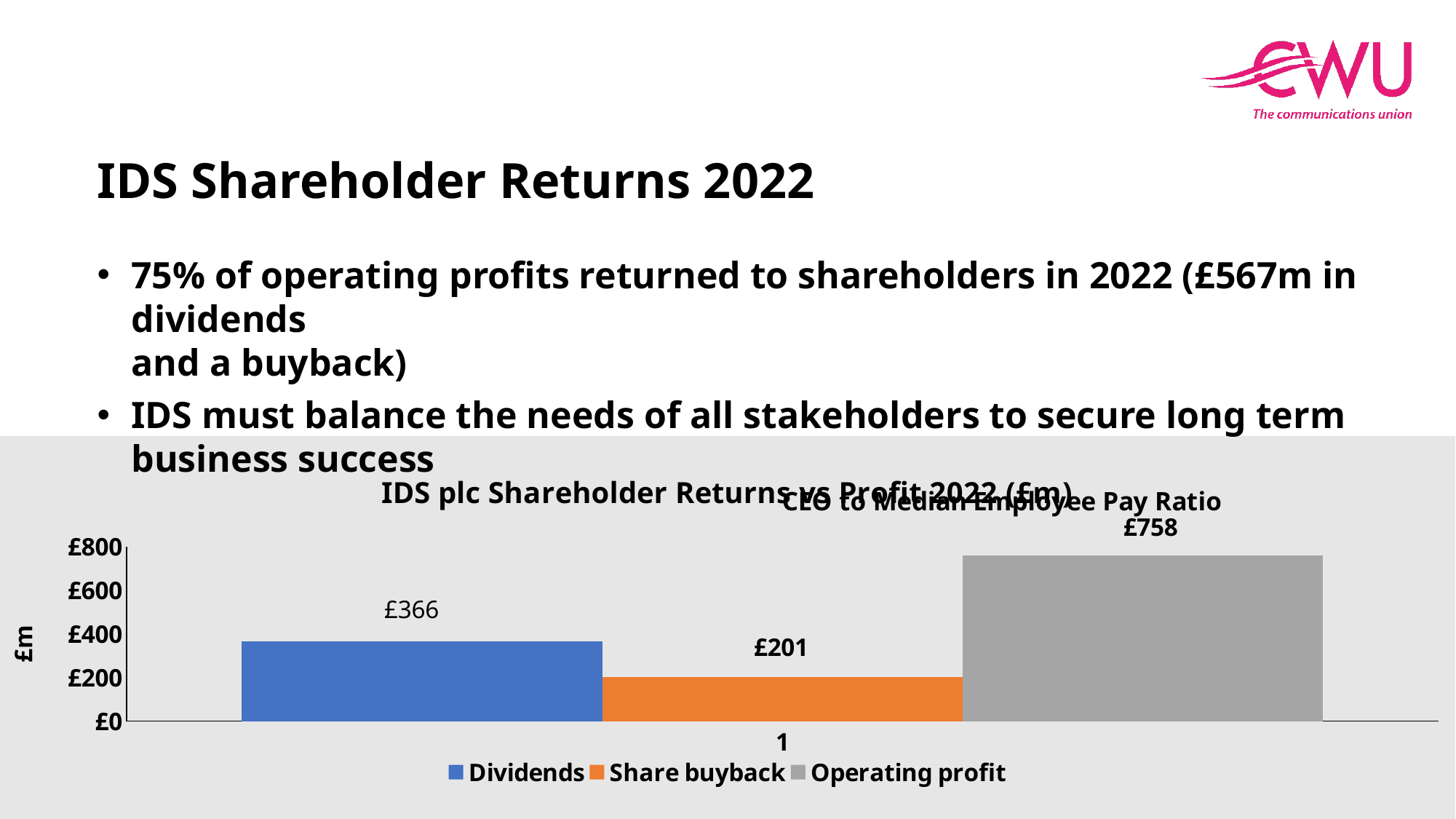
Which series has the lowest value? Share buyback Which is larger, Dividends or Share buyback? Dividends Which series has the highest value? Operating profit What is the difference between the Operating profit and Dividends values? £392 What is the label on the vertical axis? £m What kind of chart is shown? Bar chart Is the value for Operating profit greater or less than £600? greater How many series does the legend list? 3 What is the value of the Dividends bar? £366 What is the difference between the Dividends and Share buyback values? £165 What is the value of the Share buyback bar? £201 What is the value of the Operating profit bar? £758